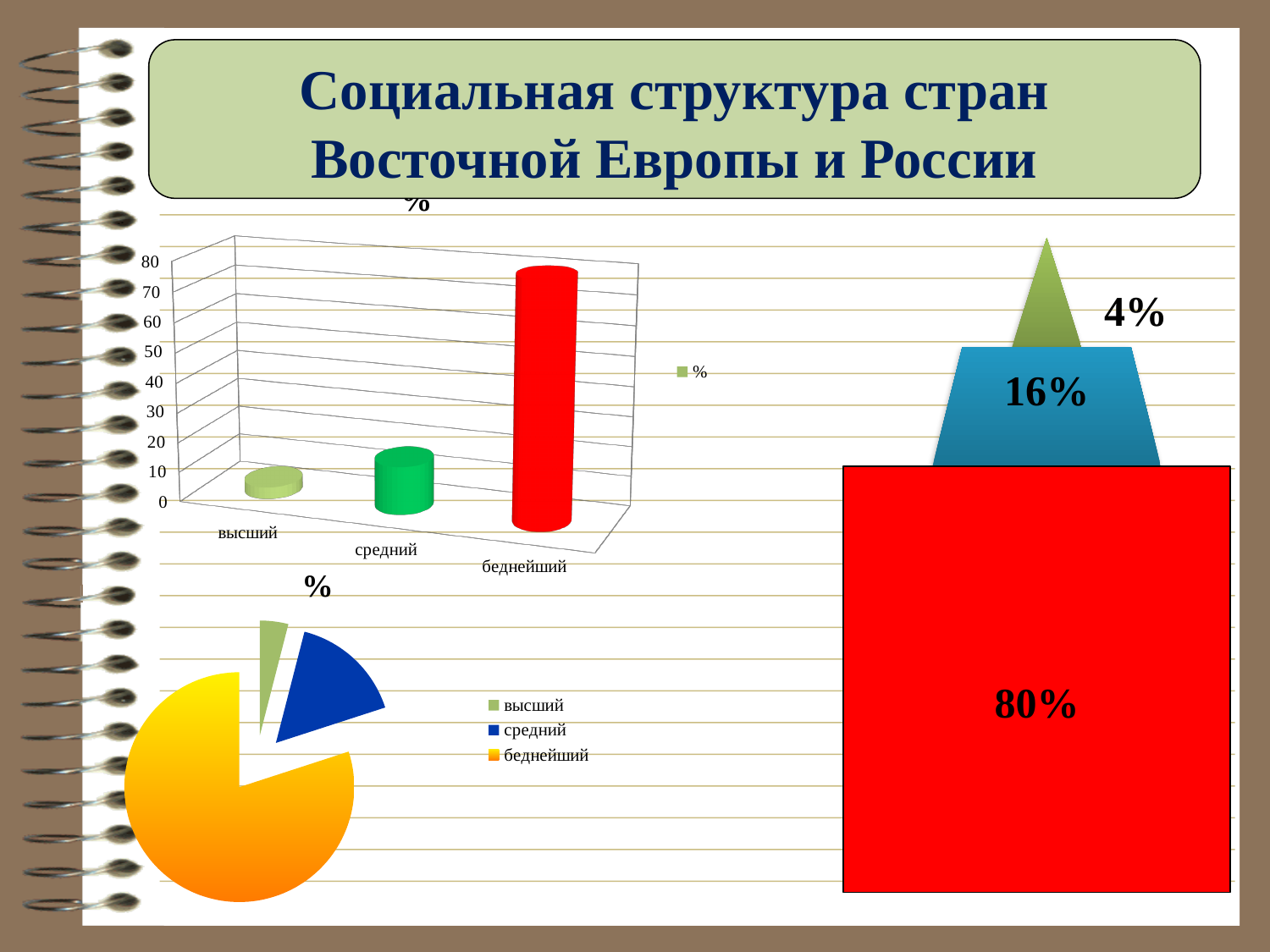
In the bottom-left pie chart, what colour is the slice for беднейший? orange/yellow In the top-left bar chart, which category has the lowest value? высший In the bottom-left pie chart, which category has the smallest slice? высший In the top-left bar chart, is the value for беднейший greater or less than 60? greater In the top-left bar chart, how many categories are shown on the x axis? 3 In the top-left bar chart, which is larger: the value for средний or the value for высший? средний What kind of chart is the top-left chart on the slide? bar chart In the top-left bar chart, which category has the highest value? беднейший What kind of chart is the bottom-left chart on the slide? pie chart In the top-left bar chart, is the value for высший greater or less than 10? less In the bottom-left pie chart, which category has the largest slice? беднейший In the top-left bar chart, how many series does the legend list? 1